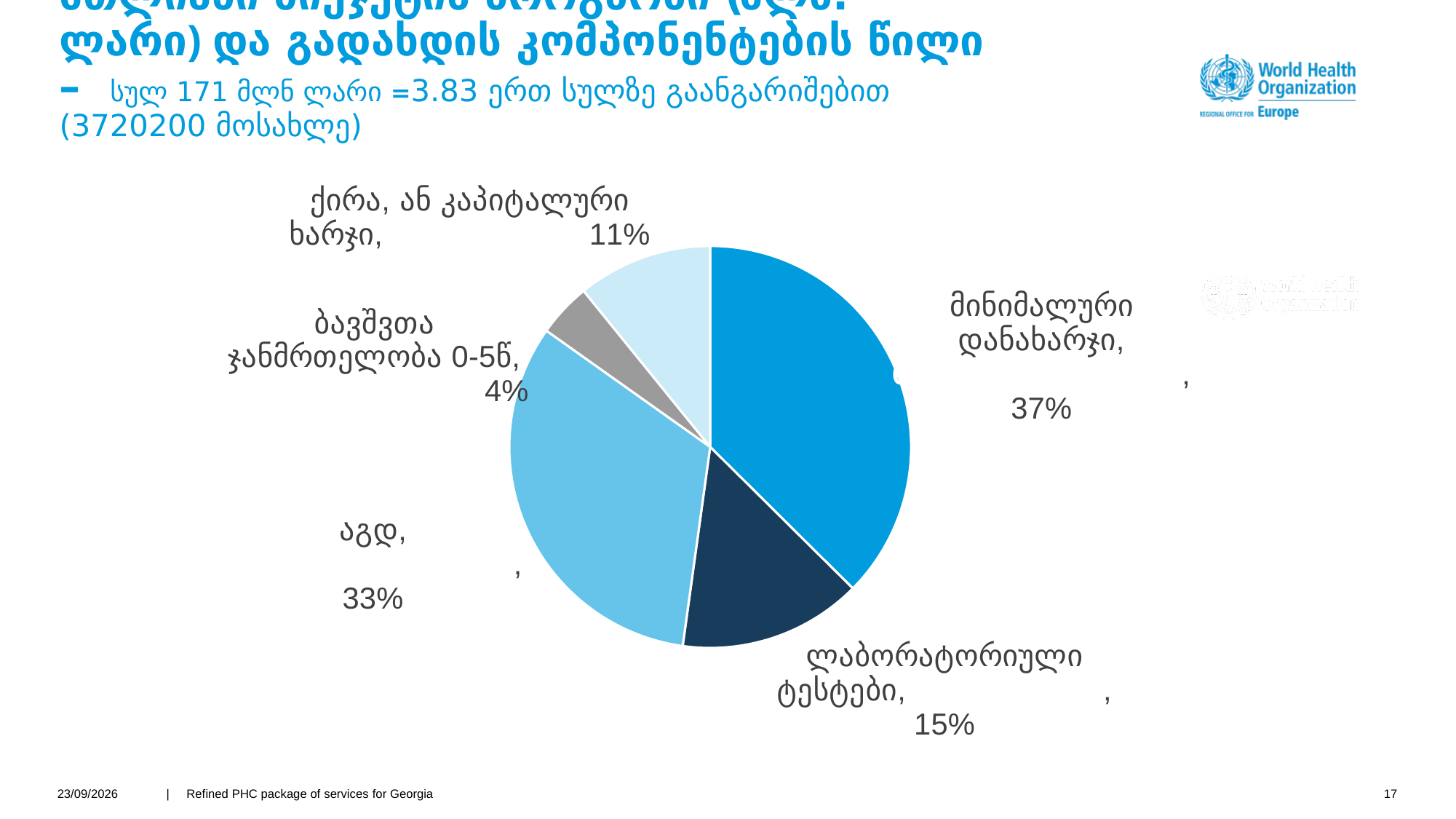
Which slice of the pie chart is the largest? მინიმალური დანახარჯი What is the difference in percentage points between the მინიმალური დანახარჯი slice and the აგდ slice? 4 What share of the pie is labelled აგდ? 33% What kind of chart is shown on the slide? pie chart What share of the pie is labelled ბავშვთა ჯანმრთელობა 0-5წ? 4% What colour is the ბავშვთა ჯანმრთელობა 0-5წ slice? grey Which slice of the pie chart is the smallest? ბავშვთა ჯანმრთელობა 0-5წ What share of the pie is labelled მინიმალური დანახარჯი? 37% Which is larger, the ლაბორატორიული ტესტები slice or the ქირა, ან კაპიტალური ხარჯი slice? ლაბორატორიული ტესტები How many slices does the pie chart have? 5